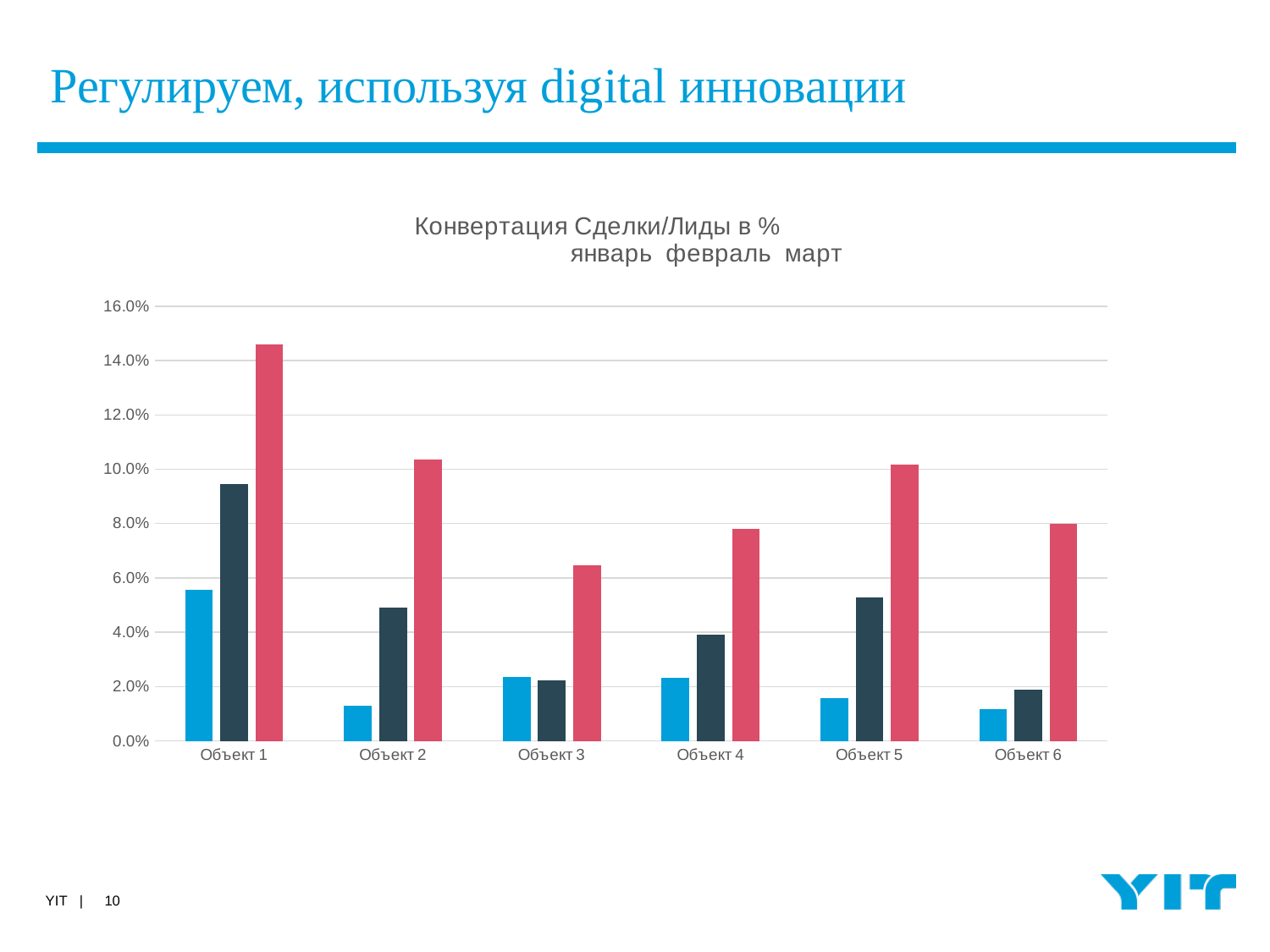
Which months are listed under the chart title? январь, февраль, март Which is larger: the light blue (январь) bar for Объект 1 or the light blue (январь) bar for Объект 2? Объект 1 Is the value of the red (март) bar for Объект 1 greater or less than 14.0%? greater What kind of chart is shown on the slide? bar chart Is the value of the dark (февраль) bar for Объект 1 greater or less than 8.0%? greater Which category has the tallest bar in the chart? Объект 1 How many months are listed under the chart title 'Конвертация Сделки/Лиды в %'? 3 Is the value of the light blue (январь) bar for Объект 2 greater or less than 2.0%? less Which category has the highest value for the second (dark) bar in each group? Объект 1 How many categories (objects) are shown on the x axis of the chart? 6 For Объект 1, do the bars rise or fall from the first (январь) bar to the third (март) bar? rise Which category has the lowest value for the third (red) bar in each group? Объект 3